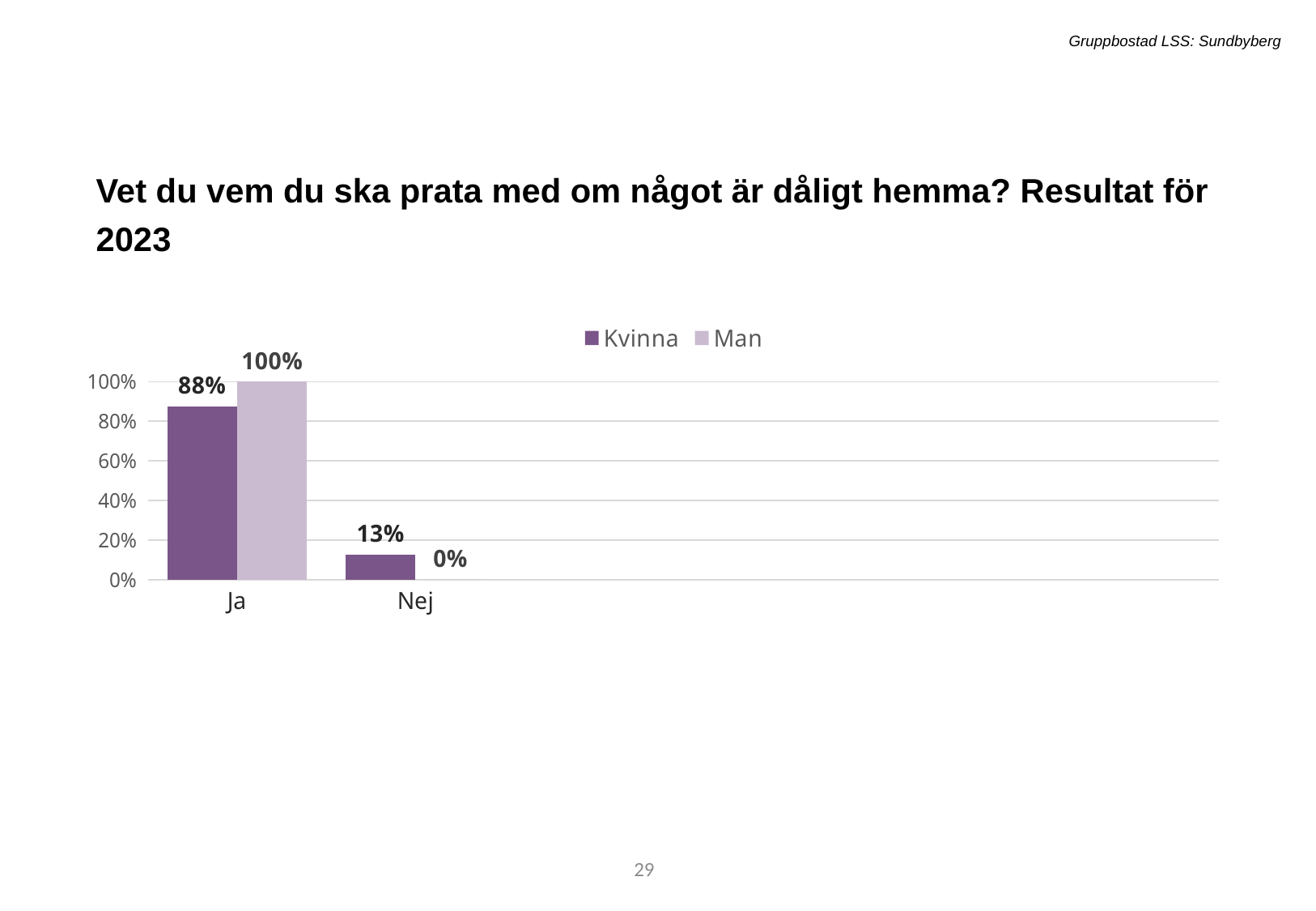
Which is larger in the Nej category, Kvinna or Man? Kvinna What is the value for Man in the Nej category? 0% Which category has the highest value for Kvinna? Ja What are the two series named in the legend? Kvinna and Man How many categories are shown on the x axis? 2 What kind of chart is shown on the slide? Bar chart What is the value for Man in the Ja category? 100% What is the value for Kvinna in the Nej category? 13% What is the difference between the Man and Kvinna values in the Ja category? 12% How many series does the legend list? 2 Which category has the lowest value for Man? Nej What is the value for Kvinna in the Ja category? 88%